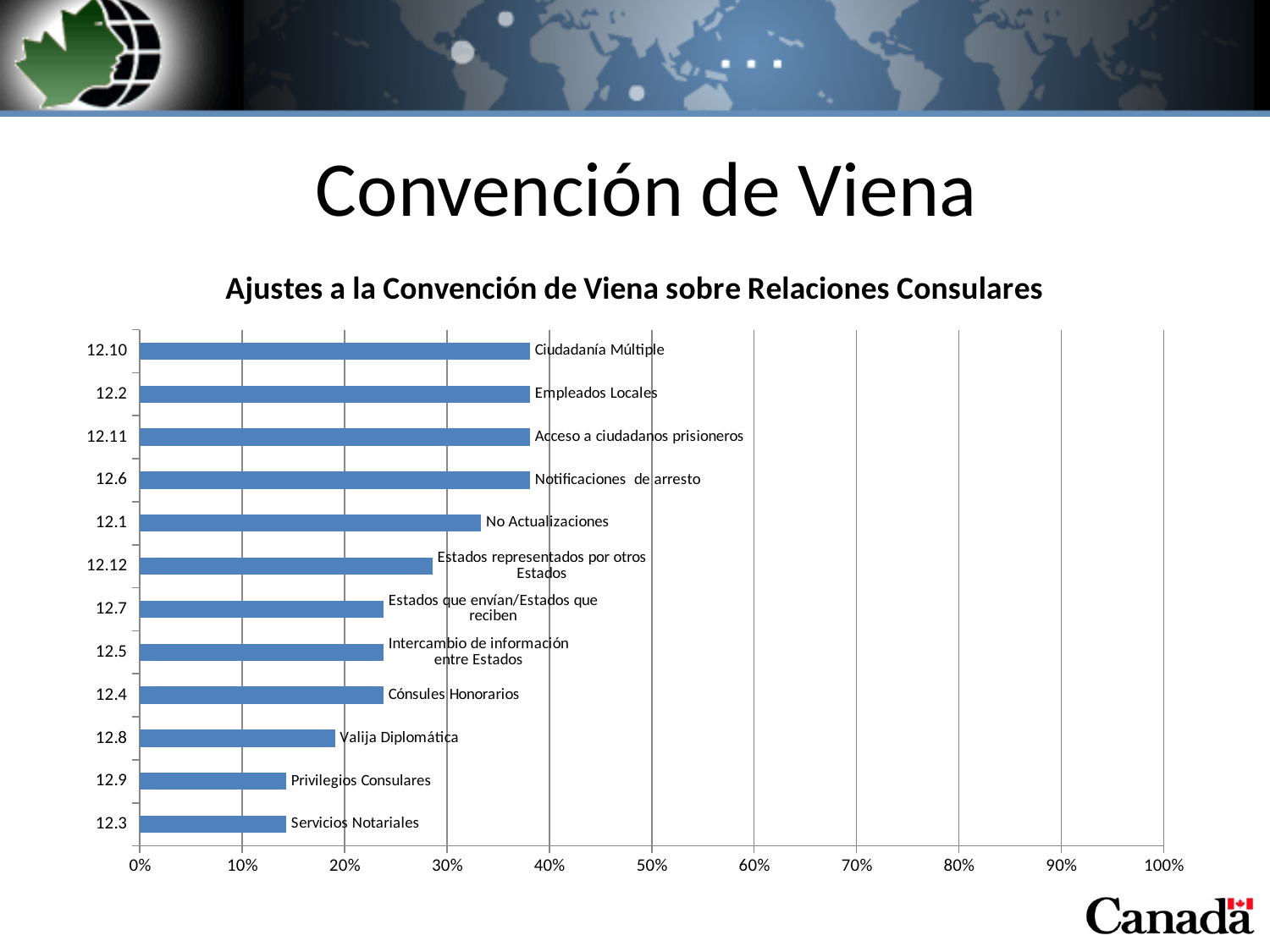
Which has the larger value, 12.8 or 12.4? 12.4 How many categories are plotted in the chart? 12 What is the title of the chart? Ajustes a la Convención de Viena sobre Relaciones Consulares Is the value for 12.3 greater or less than 20%? less Is the value for 12.10 greater or less than 30%? greater Which has the larger value, 12.1 or 12.12? 12.1 Is the value for 12.8 greater or less than 10%? greater What type of chart is shown on the slide? bar chart What text label is shown next to the bar for 12.10? Ciudadanía Múltiple Do the bar values rise or fall going from the top category (12.10) to the bottom category (12.3)? fall